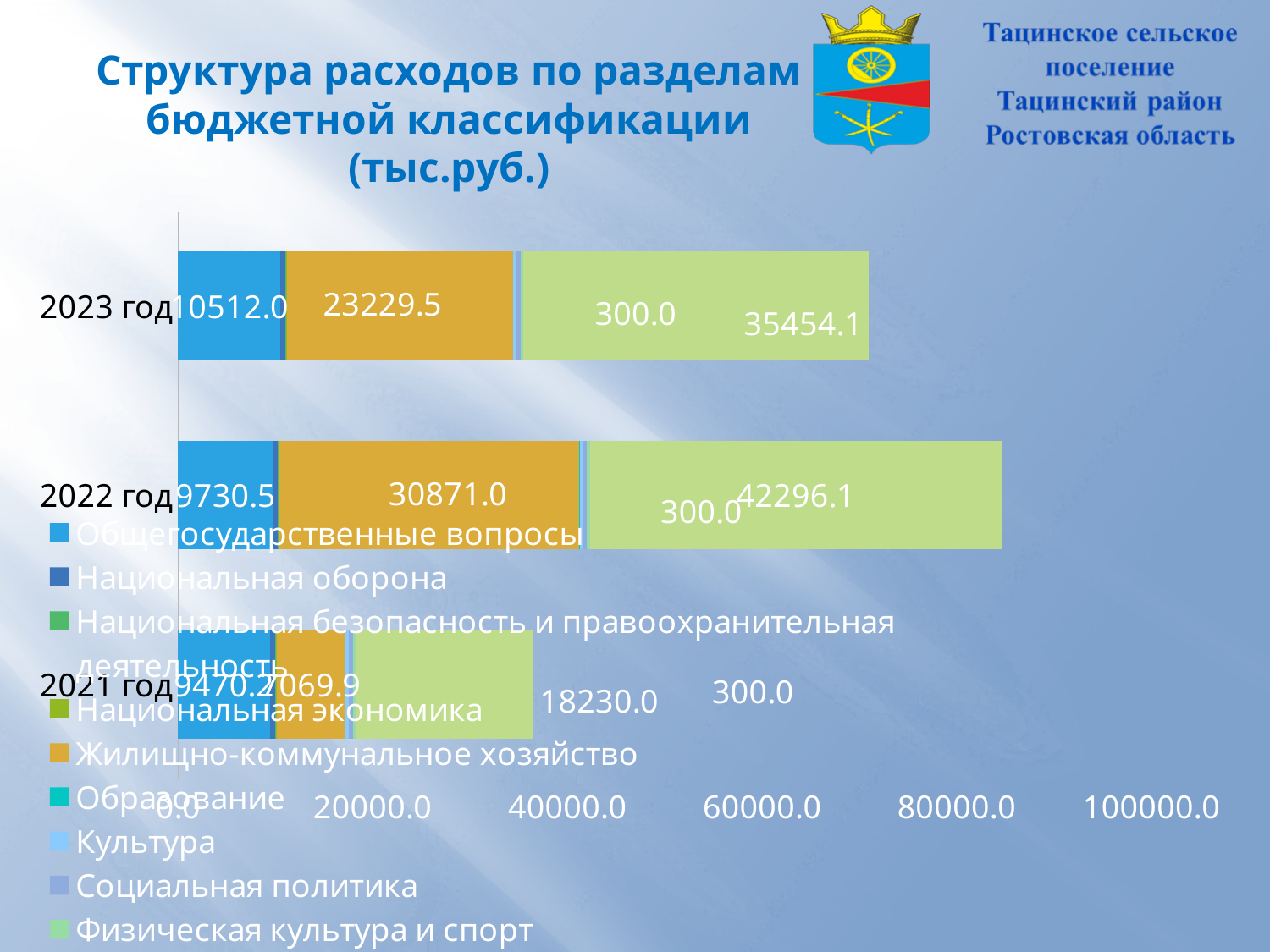
In which year is the value for Жилищно-коммунальное хозяйство the highest? 2022 год What is the value for Общегосударственные вопросы in 2021 год? 9470.2 What is the value for Жилищно-коммунальное хозяйство in 2021 год? 7069.9 What is the value for Жилищно-коммунальное хозяйство in 2022 год? 30871.0 How many series does the chart legend list? 9 What is the value for Общегосударственные вопросы in 2023 год? 10512.0 How many years (categories) are shown on the chart? 3 What is the title of the chart? Структура расходов по разделам бюджетной классификации (тыс.руб.) Which year has the larger value for Общегосударственные вопросы, 2023 год or 2022 год? 2023 год Is the total length of the 2022 год bar greater or less than 80000.0? greater What is the difference between the Жилищно-коммунальное хозяйство values for 2022 год and 2023 год? 7641.5 What kind of chart is shown on the slide? stacked bar chart